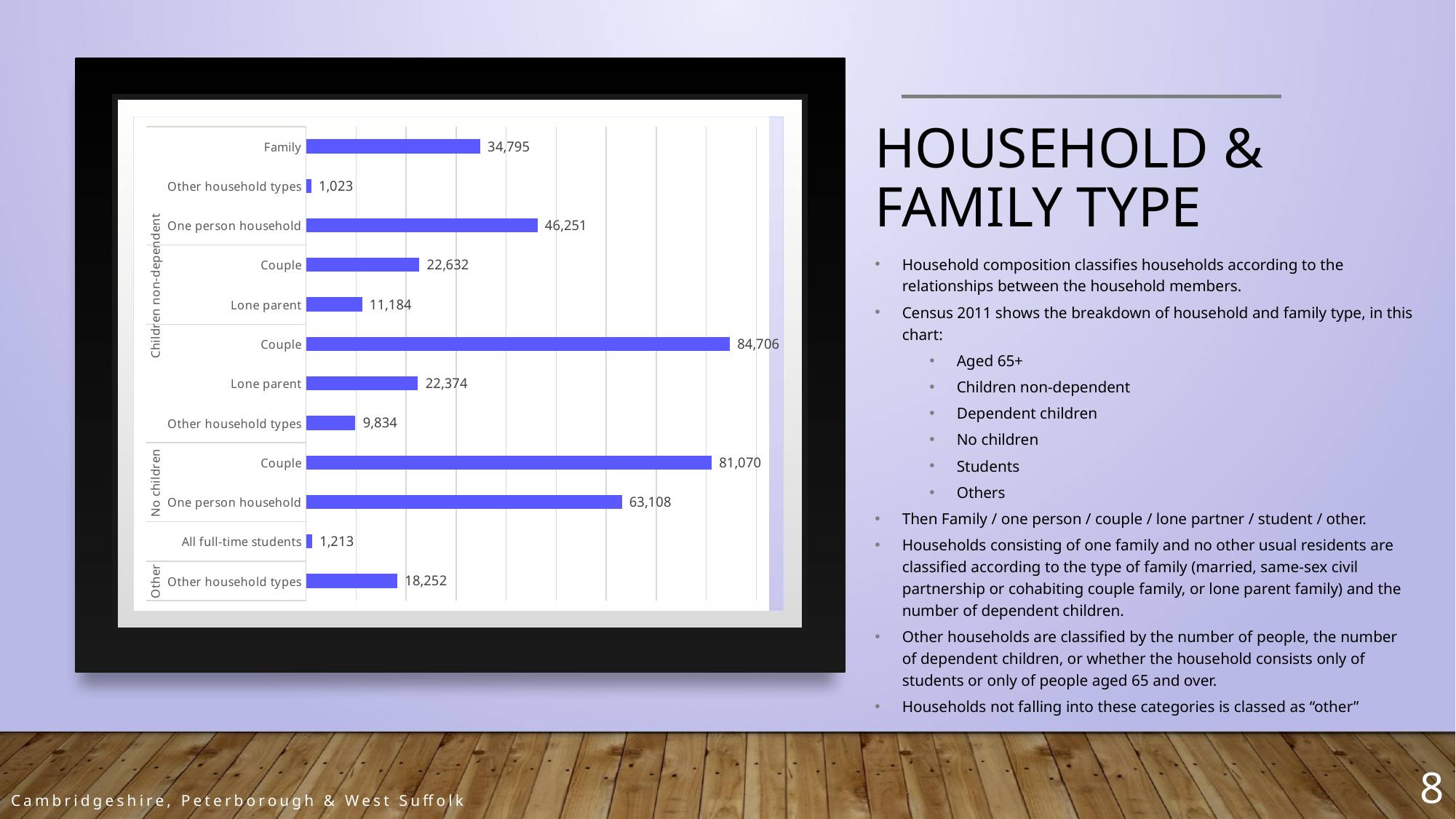
What is the value for All full-time students? 1,213 What is the value for Lone parent in the Children non-dependent group? 11,184 What is the value for Other household types in the Other group? 18,252 What type of chart is shown on the slide? bar chart What is the smallest value shown in the chart? 1,023 What is the largest value shown in the chart? 84,706 What is the difference between Couple and Lone parent in the Children non-dependent group? 11,448 How many bars are plotted in the chart? 12 In the No children group, which is larger: Couple or One person household? Couple What is the difference between Couple and One person household in the No children group? 17,962 What is the value for Family in the chart? 34,795 What is the value for One person household in the No children group? 63,108